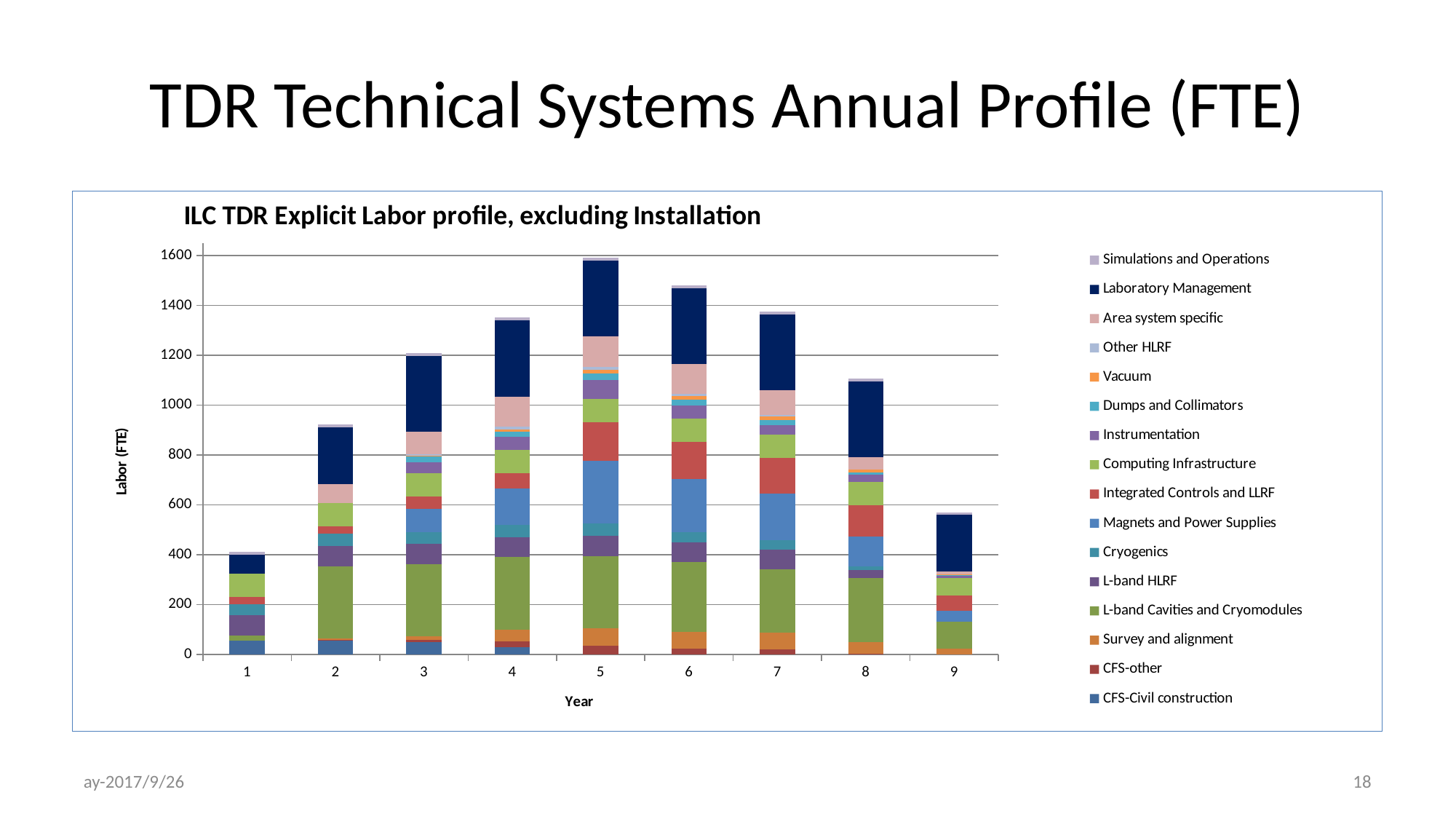
What kind of chart is shown on the slide? Stacked bar chart Do the total labor values rise or fall from year 5 to year 9? fall Is the total labor for year 2 greater or less than 1000? less Which year has the lowest total labor (FTE)? 1 What is the title of the chart? ILC TDR Explicit Labor profile, excluding Installation Is the total labor for year 8 greater or less than 1000? greater Which year has the highest total labor (FTE)? 5 How many years are shown on the x axis of the chart? 9 Which year has a larger total labor, year 6 or year 7? 6 How many series does the chart legend list? 16 Is the total labor for year 1 greater or less than 600? less